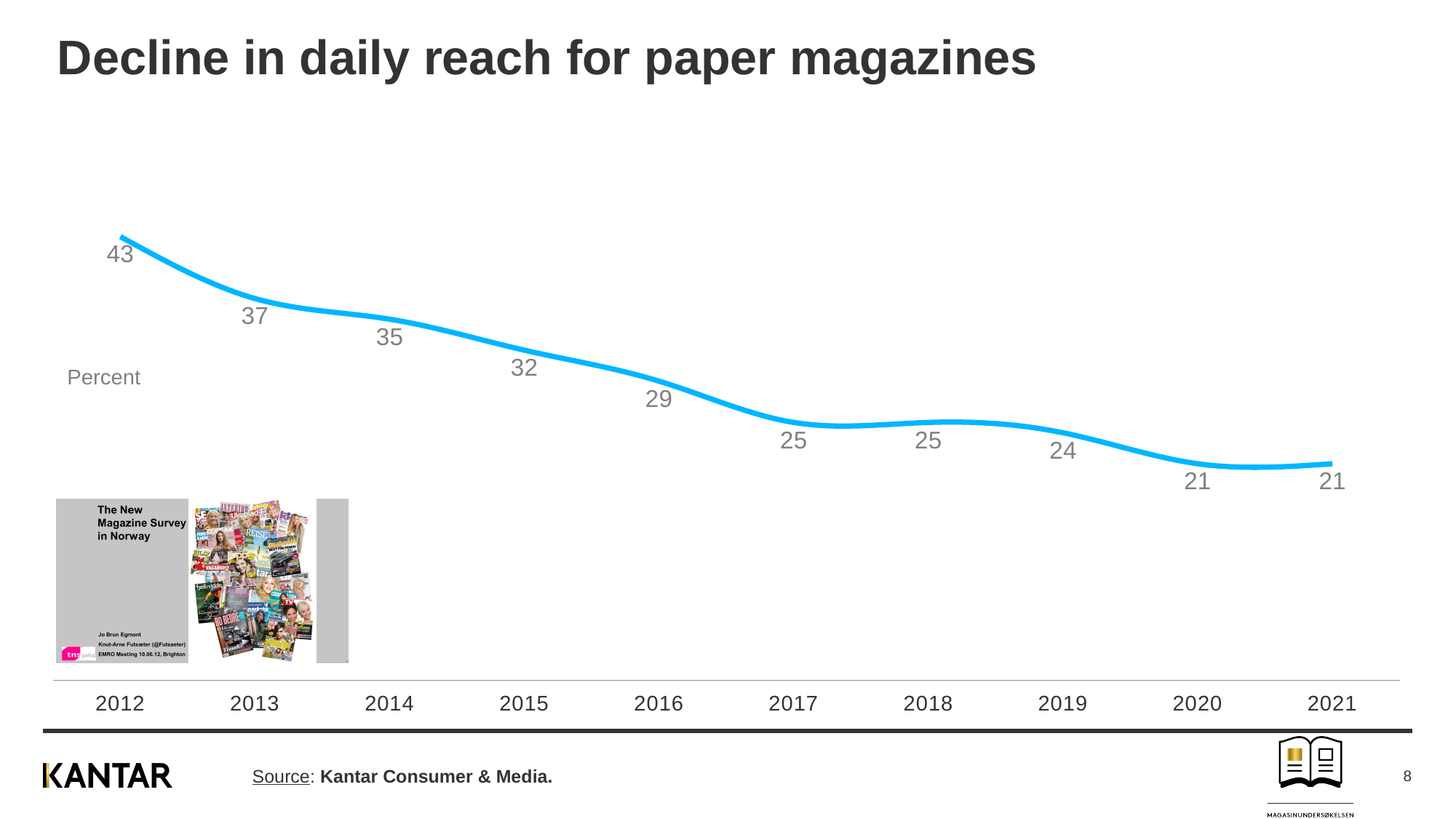
Which is larger, the value for 2015 or the value for 2019? 2015 What unit is indicated for the values on the chart? Percent What is the difference between the values for 2012 and 2021? 22 What is the daily reach value for 2012? 43 What is the daily reach value for 2016? 29 What is the difference between the values for 2013 and 2014? 2 What is the lowest value shown on the chart? 21 Which year has the highest daily reach value? 2012 What kind of chart is shown on the slide? Line chart Do the values generally rise or fall from 2012 to 2021? Fall How many years are plotted on the chart? 10 What is the daily reach value for 2021? 21